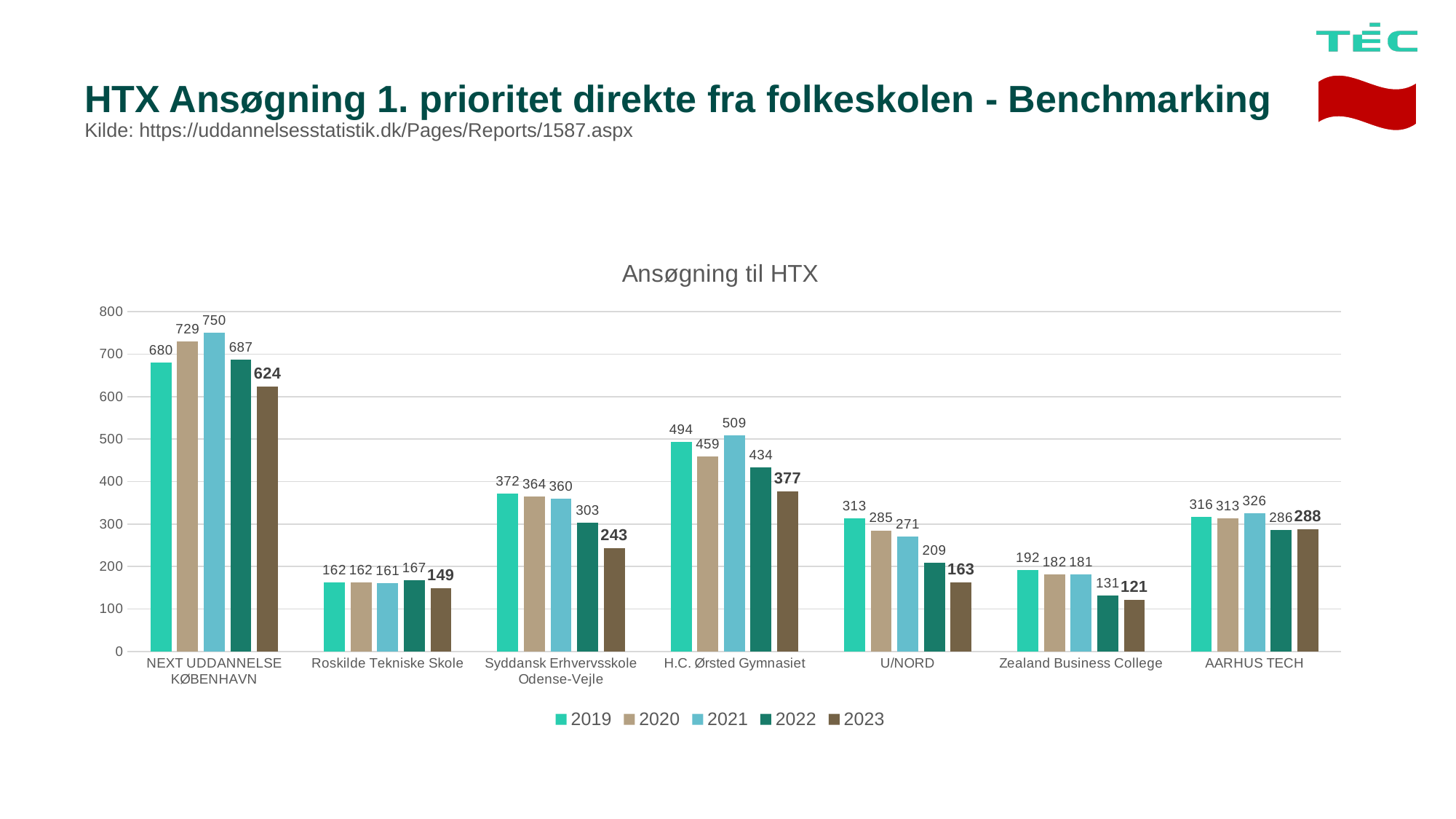
How many series does the legend list? 5 How many schools are shown on the x axis? 7 Which school has the lowest value in 2023? Zealand Business College What kind of chart is shown? bar chart What is the value for Zealand Business College in 2022? 131 What is the title of the chart? Ansøgning til HTX What is the value for NEXT UDDANNELSE KØBENHAVN in 2021? 750 What is the difference between the 2019 and 2023 values for U/NORD? 150 Which is larger for AARHUS TECH: the 2021 value or the 2022 value? 2021 Do the values for Syddansk Erhvervsskole Odense-Vejle rise or fall from 2019 to 2023? fall Which school has the highest value in 2019? NEXT UDDANNELSE KØBENHAVN What is the value for H.C. Ørsted Gymnasiet in 2023? 377